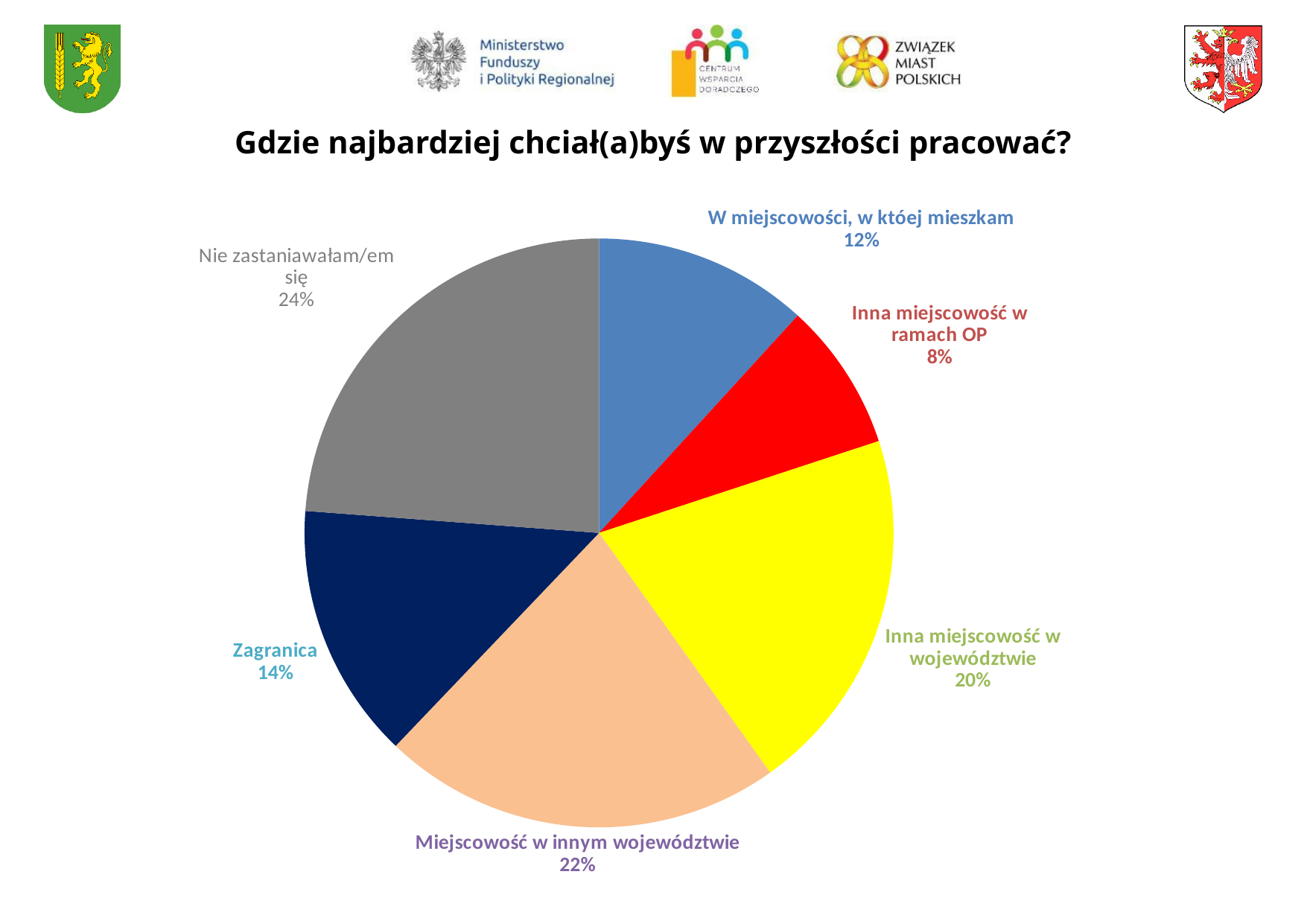
Which is larger: "Inna miejscowość w województwie" or "Miejscowość w innym województwie"? Miejscowość w innym województwie What value is shown for "W miejscowości, w któej mieszkam"? 12% What colour is the slice for "Inna miejscowość w województwie"? Yellow What is the title of the chart? Gdzie najbardziej chciał(a)byś w przyszłości pracować? What is the difference in percentage points between "Nie zastaniawałam/em się" and "Zagranica"? 10 Which category has the smallest share of the pie? Inna miejscowość w ramach OP What share is shown for "Inna miejscowość w ramach OP"? 8% What percentage is shown for "Miejscowość w innym województwie"? 22% What type of chart is shown on the slide? Pie chart How many categories does the pie chart show? 6 Which category has the largest share of the pie? Nie zastaniawałam/em się What percentage of respondents chose "Zagranica"? 14%